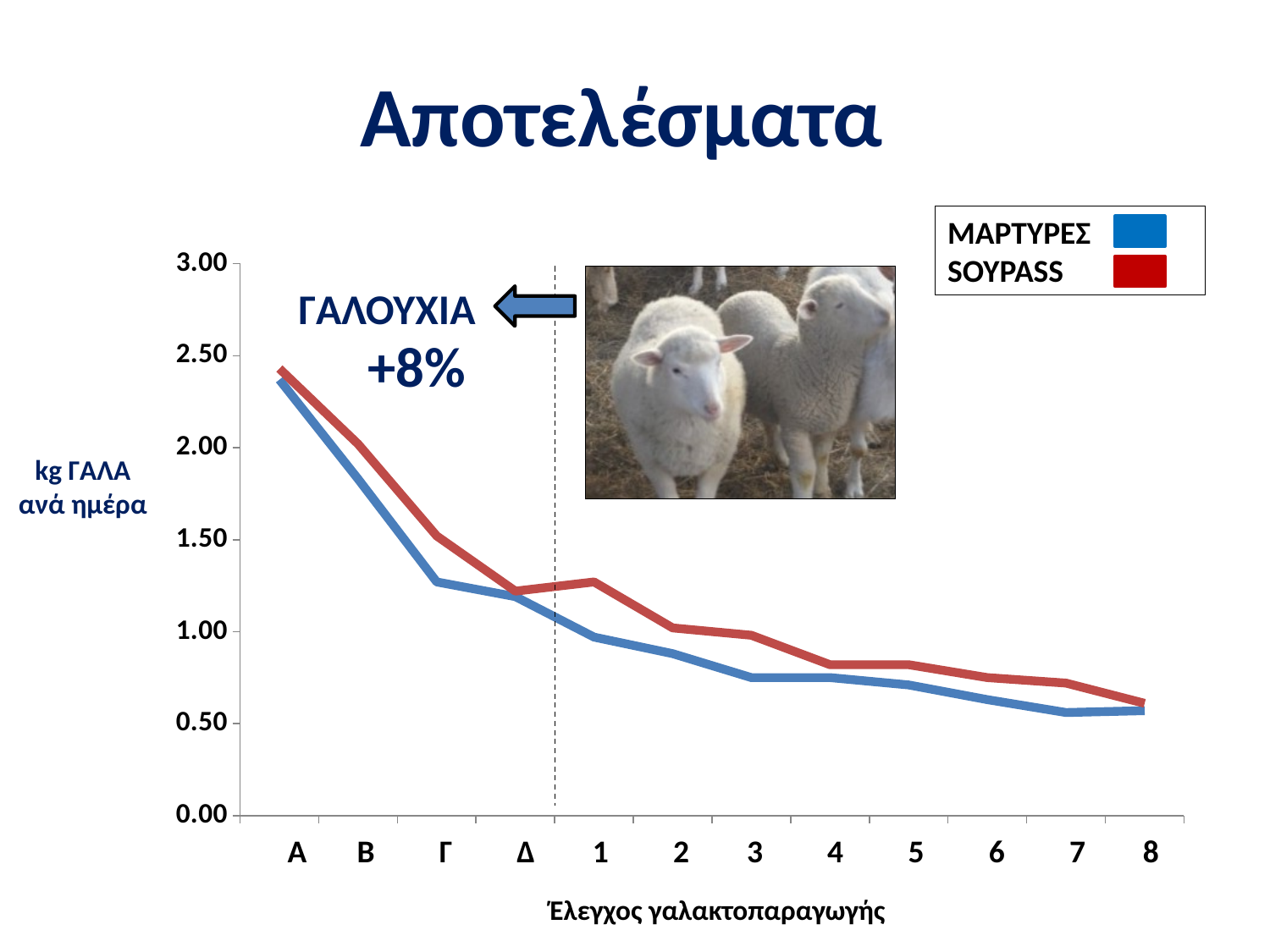
Is the value for ΜΑΡΤΥΡΕΣ at Γ greater or less than 1.00? greater Do the values for ΜΑΡΤΥΡΕΣ rise or fall from Α to 8 along the x axis? fall How many series does the legend list? 2 How many categories are shown along the x axis? 12 Is the value for SOYPASS at Α greater or less than 2.00? greater Is the value for SOYPASS at 1 greater or less than 1.00? greater Which colour represents SOYPASS in the legend? red At Γ, which series has the larger value, ΜΑΡΤΥΡΕΣ or SOYPASS? SOYPASS What is the title of the x axis? Έλεγχος γαλακτοπαραγωγής What kind of chart is shown on the slide? line chart